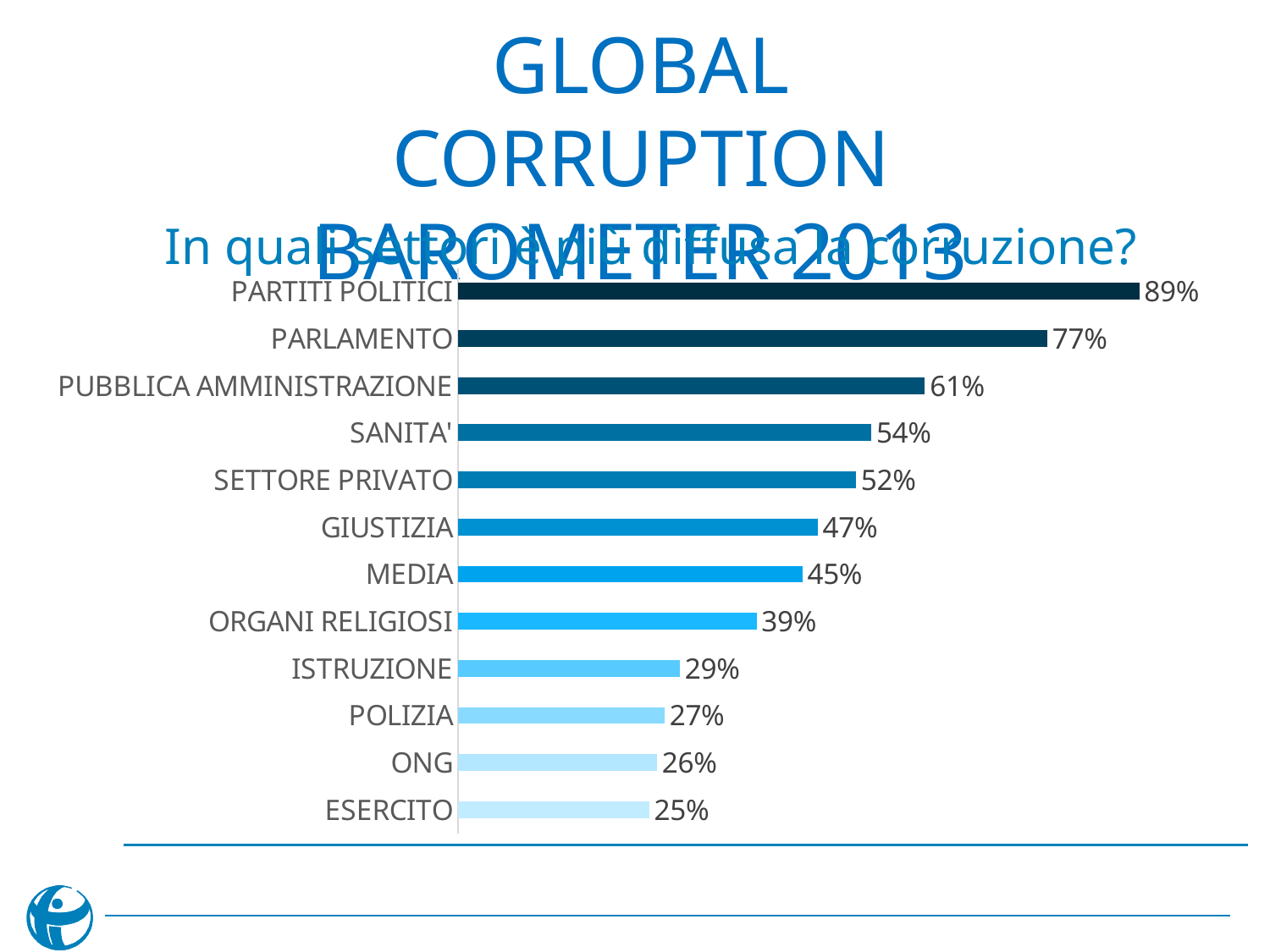
Which category has the highest value? PARTITI POLITICI How many categories are shown in the chart? 12 What is the value for SANITA'? 54% What is the difference between the values for PUBBLICA AMMINISTRAZIONE and MEDIA? 16% Which category has the lowest value? ESERCITO Do the values increase or decrease going from the top category to the bottom category? Decrease What is the value for ORGANI RELIGIOSI? 39% What kind of chart is shown on the slide? Bar chart What is the difference between the values for PARTITI POLITICI and PARLAMENTO? 12% Which is larger, the value for GIUSTIZIA or the value for ISTRUZIONE? GIUSTIZIA What is the value for PARTITI POLITICI? 89% What is the value for ESERCITO? 25%